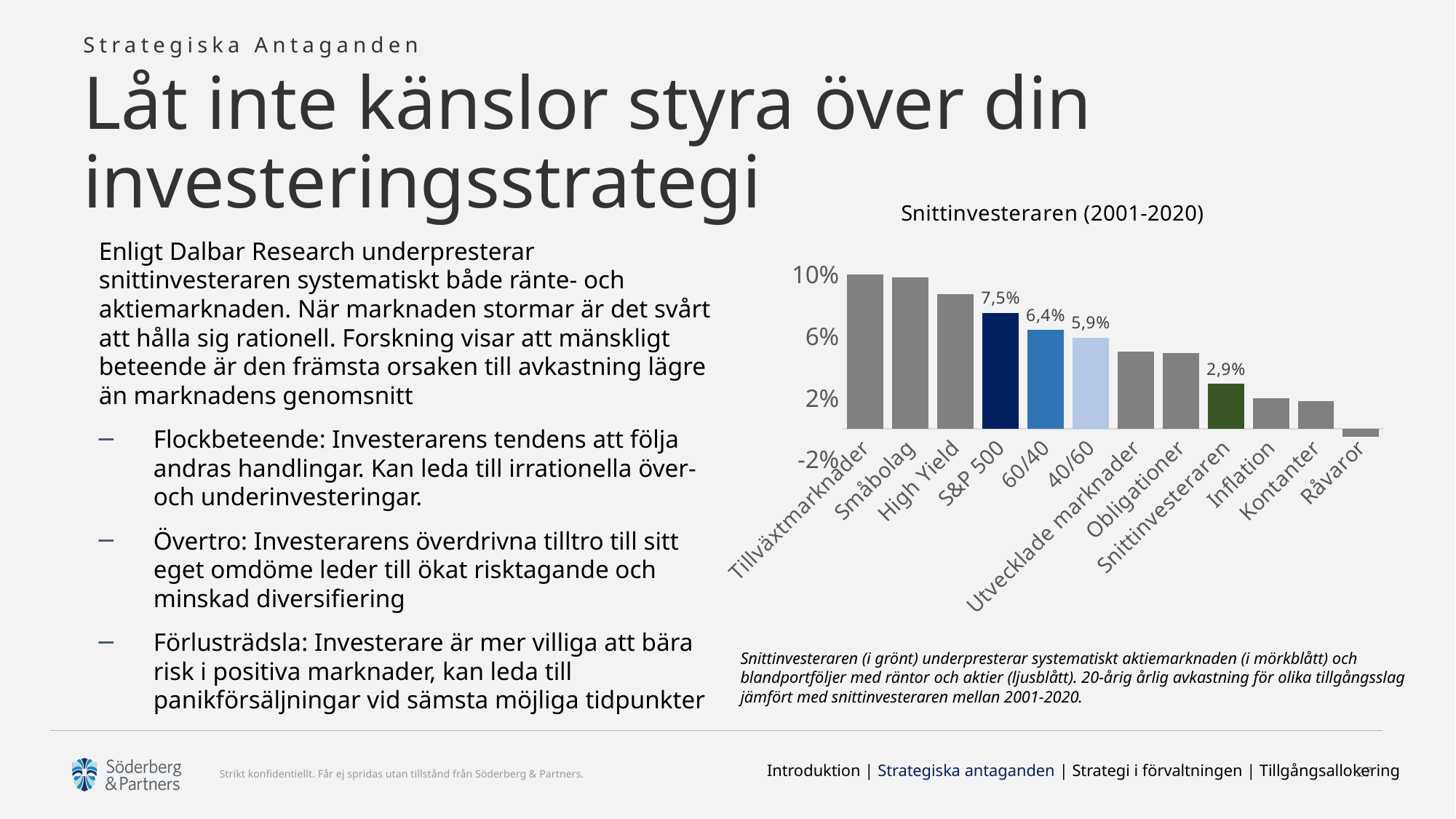
What kind of chart is shown on the slide? Bar chart What is the title of the chart? Snittinvesteraren (2001-2020) Is the value for Tillväxtmarknader greater or less than 6%? greater What is the difference between the values for S&P 500 and Snittinvesteraren? 4,6 percentage points How many categories are shown in the chart? 12 Which is larger, the value for S&P 500 or the value for 60/40? S&P 500 What is the value for Snittinvesteraren in the chart? 2,9% What is the value for S&P 500 in the chart? 7,5% What is the value for 60/40 in the chart? 6,4% What is the value for 40/60 in the chart? 5,9% Which category has the lowest value in the chart? Råvaror Is the value for Råvaror greater or less than 2%? less